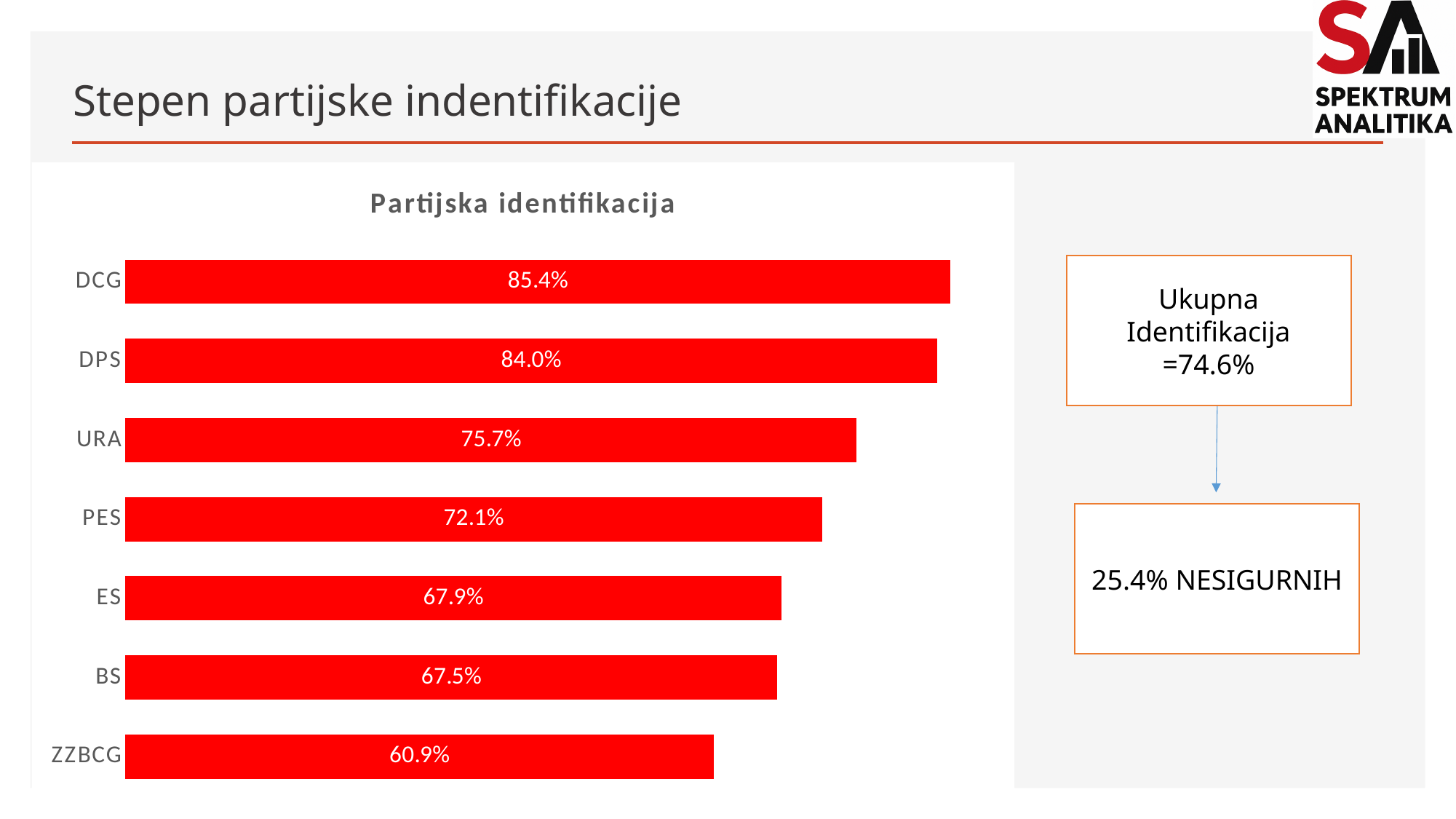
Which is larger, the value for URA or the value for PES? URA What is the title of the chart? Partijska identifikacija What kind of chart is shown on the slide? Bar chart What is the difference between the values for DCG and DPS? 1.4% Which category has the lowest value? ZZBCG What is the difference between the values for PES and ZZBCG? 11.2% What is the value for ZZBCG? 60.9% What is the value for DCG? 85.4% How many categories are shown in the chart? 7 What colour are the bars in the chart? Red Which category has the highest value? DCG What is the value for URA? 75.7%